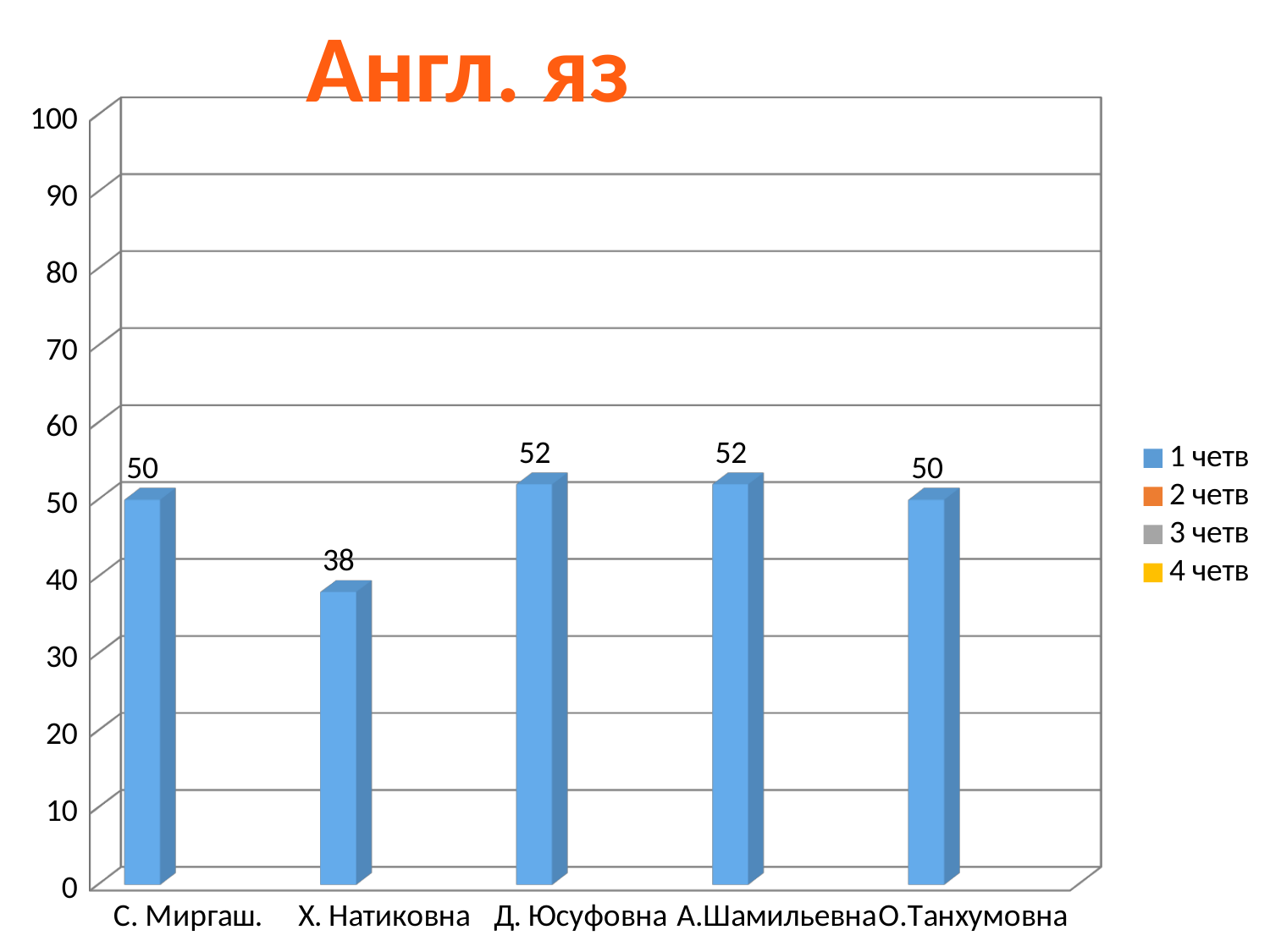
Which is larger, the value for О.Танхумовна or the value for Х. Натиковна? О.Танхумовна What is the title of the chart? Англ. яз How many categories are shown on the x axis? 5 What kind of chart is shown on the slide? bar chart What colour are the bars for the 1 четв series? blue How many series does the legend list? 4 What is the value for Д. Юсуфовна in the 1 четв series? 52 What is the value for С. Миргаш. in the 1 четв series? 50 What is the value for Х. Натиковна in the 1 четв series? 38 What is the difference between the values for Д. Юсуфовна and Х. Натиковна? 14 Is the value for Х. Натиковна greater or less than 40? less Which category has the lowest value? Х. Натиковна